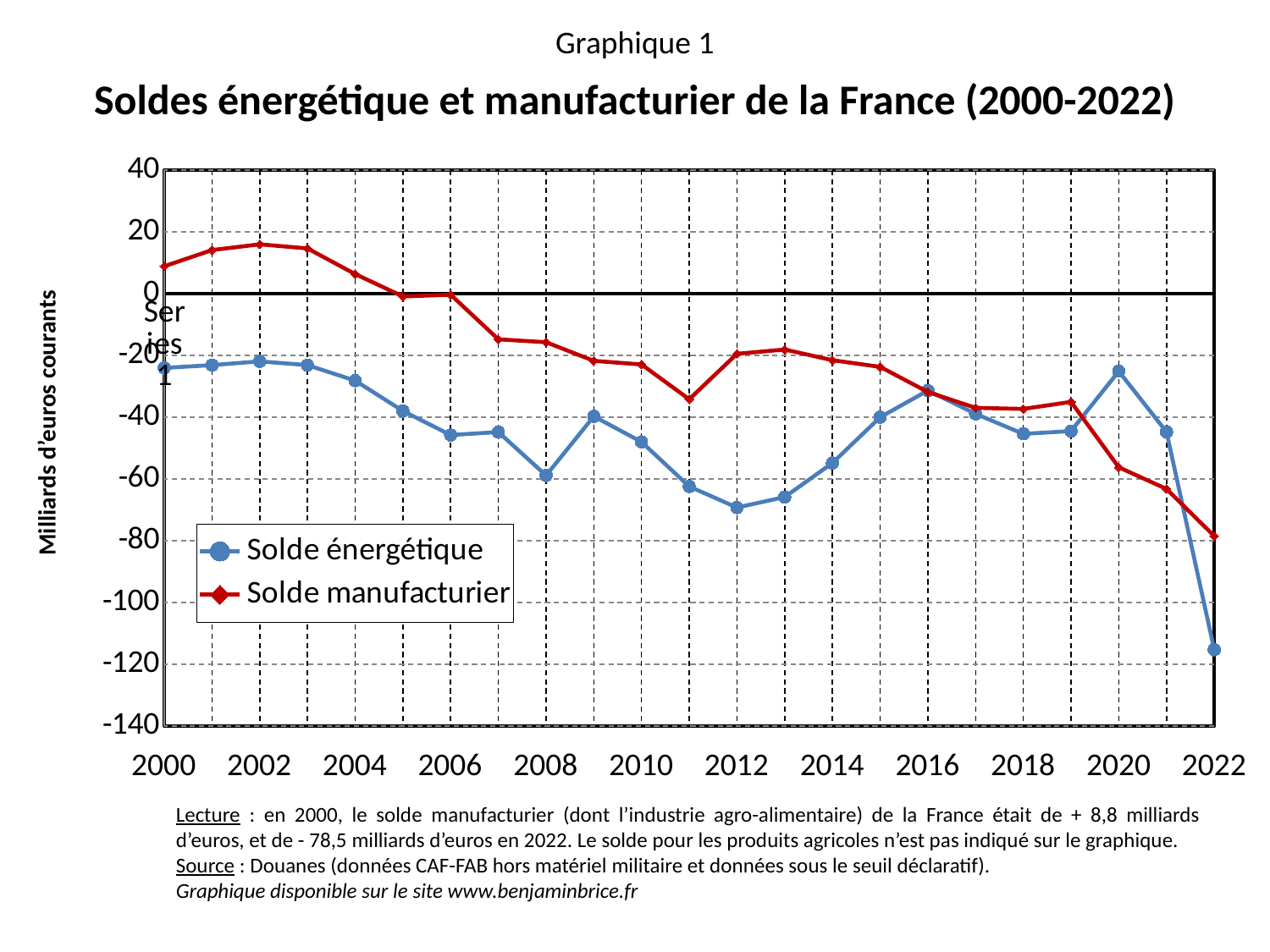
According to the slide, what was the solde manufacturier of France in 2000? + 8,8 milliards d'euros In which year does Solde énergétique reach its lowest value? 2022 By how much did the solde manufacturier fall between 2000 and 2022? 87,3 milliards d'euros According to the slide, what was the solde manufacturier of France in 2022? - 78,5 milliards d'euros What kind of chart is shown on the slide? line chart Is the value of Solde énergétique in 2022 greater or less than -100? less What is the label of the vertical axis? Milliards d'euros courants Is the value of Solde manufacturier in 2011 greater or less than -20? less Does Solde manufacturier rise or fall between 2019 and 2022? fall How many series does the legend list? 2 What are the two series named in the legend? Solde énergétique and Solde manufacturier In 2020, which series has the higher value, Solde énergétique or Solde manufacturier? Solde énergétique